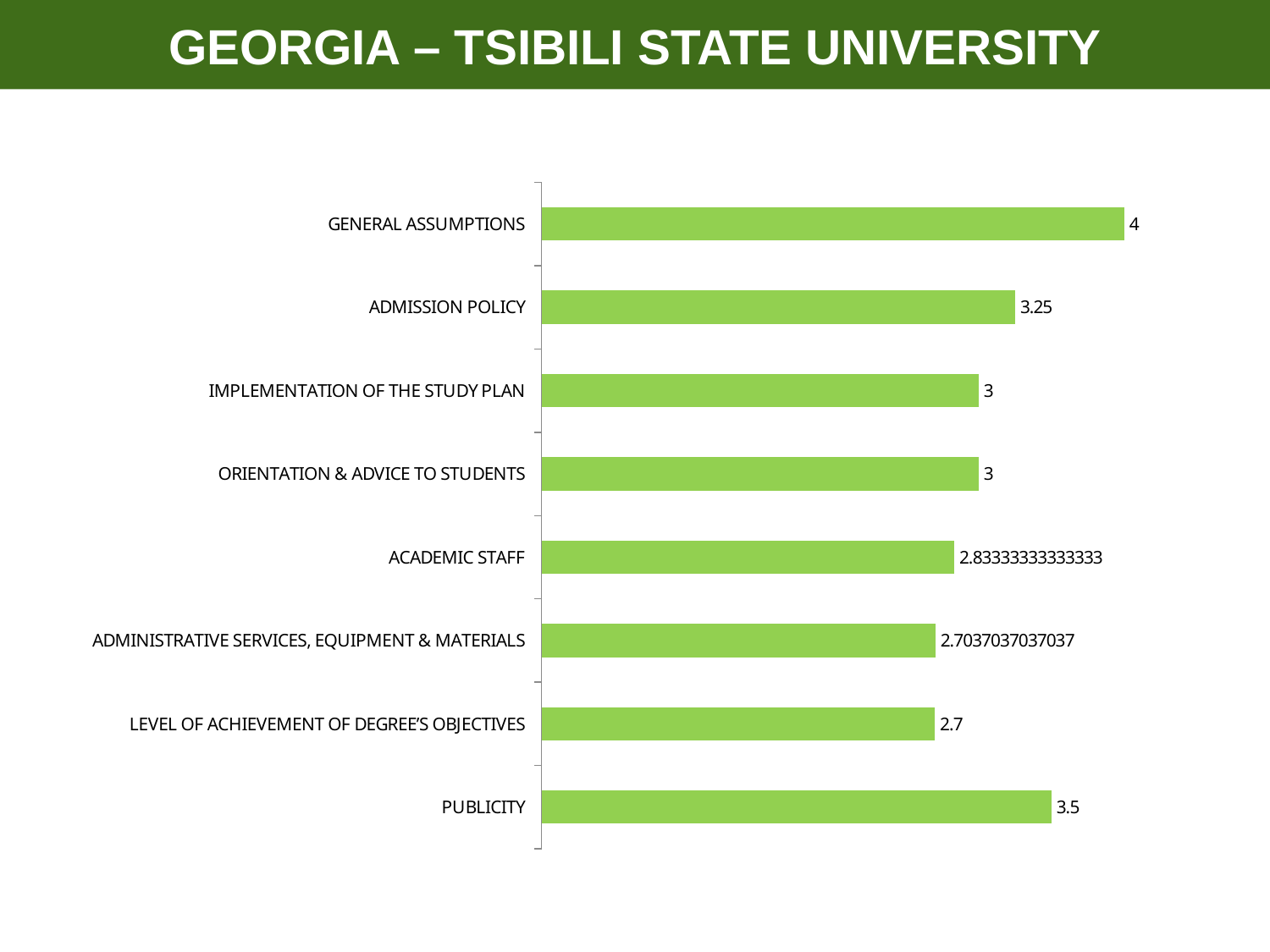
What is the difference between the values for GENERAL ASSUMPTIONS and ADMISSION POLICY? 0.75 What kind of chart is shown on the slide? Bar chart What colour are the bars in the chart? Green What is the value for LEVEL OF ACHIEVEMENT OF DEGREE'S OBJECTIVES? 2.7 Which category has the lowest value? LEVEL OF ACHIEVEMENT OF DEGREE'S OBJECTIVES What is the value for ACADEMIC STAFF? 2.83333333333333 Which category has the highest value? GENERAL ASSUMPTIONS What is the value for PUBLICITY? 3.5 Which is larger, the value for PUBLICITY or the value for ADMISSION POLICY? PUBLICITY What is the value for GENERAL ASSUMPTIONS? 4 How many categories are shown in the chart? 8 What is the value for ADMISSION POLICY? 3.25